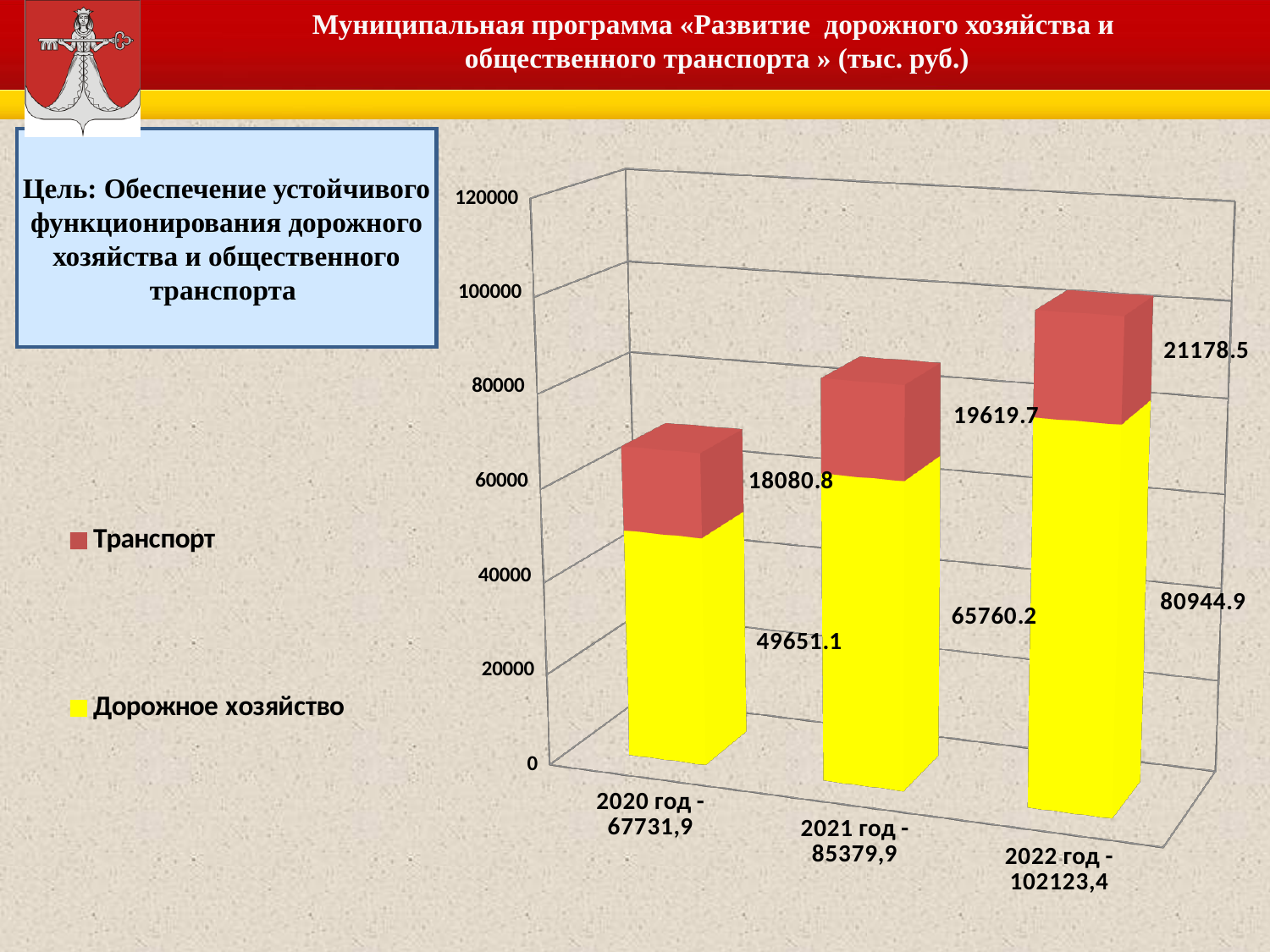
How many years are shown on the x axis? 3 What is the value for Транспорт in 2022? 21178.5 What is the total of the stacked bar for 2021? 85379.9 What is the value for Дорожное хозяйство in 2020? 49651.1 How many series does the legend list? 2 Which year has the highest value for Дорожное хозяйство? 2022 What kind of chart is shown on the slide? Stacked bar chart Which is larger: Транспорт in 2021 or Транспорт in 2020? Транспорт in 2021 What is the value for Транспорт in 2021? 19619.7 What is the difference between the Дорожное хозяйство values for 2022 and 2021? 15184.7 Do the Дорожное хозяйство values rise or fall from 2020 to 2022? Rise Which year has the lowest value for Транспорт? 2020